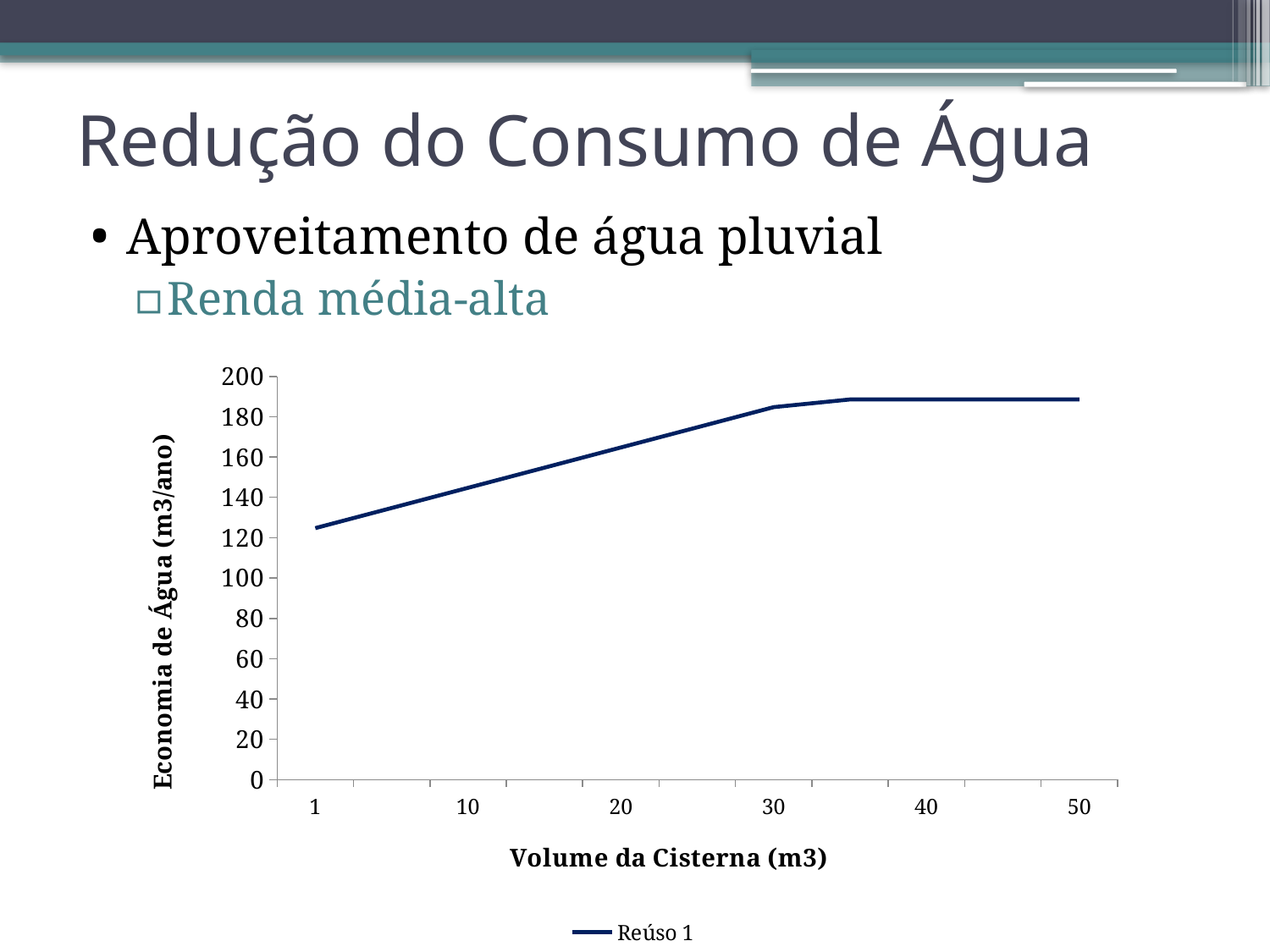
What kind of chart is shown on the slide? line chart Is the value for Volume da Cisterna 1 greater or less than 140? less Is the value for Volume da Cisterna 50 greater or less than 180? greater Does the Reúso 1 line generally rise or fall as Volume da Cisterna increases from 1 to 30? rise What is the title of the chart's vertical axis? Economia de Água (m3/ano) How many series does the chart legend list? 1 Is the value for Volume da Cisterna 30 greater or less than 160? greater Which has the larger value, Volume da Cisterna 1 or Volume da Cisterna 40? Volume da Cisterna 40 What is the name of the series shown in the chart legend? Reúso 1